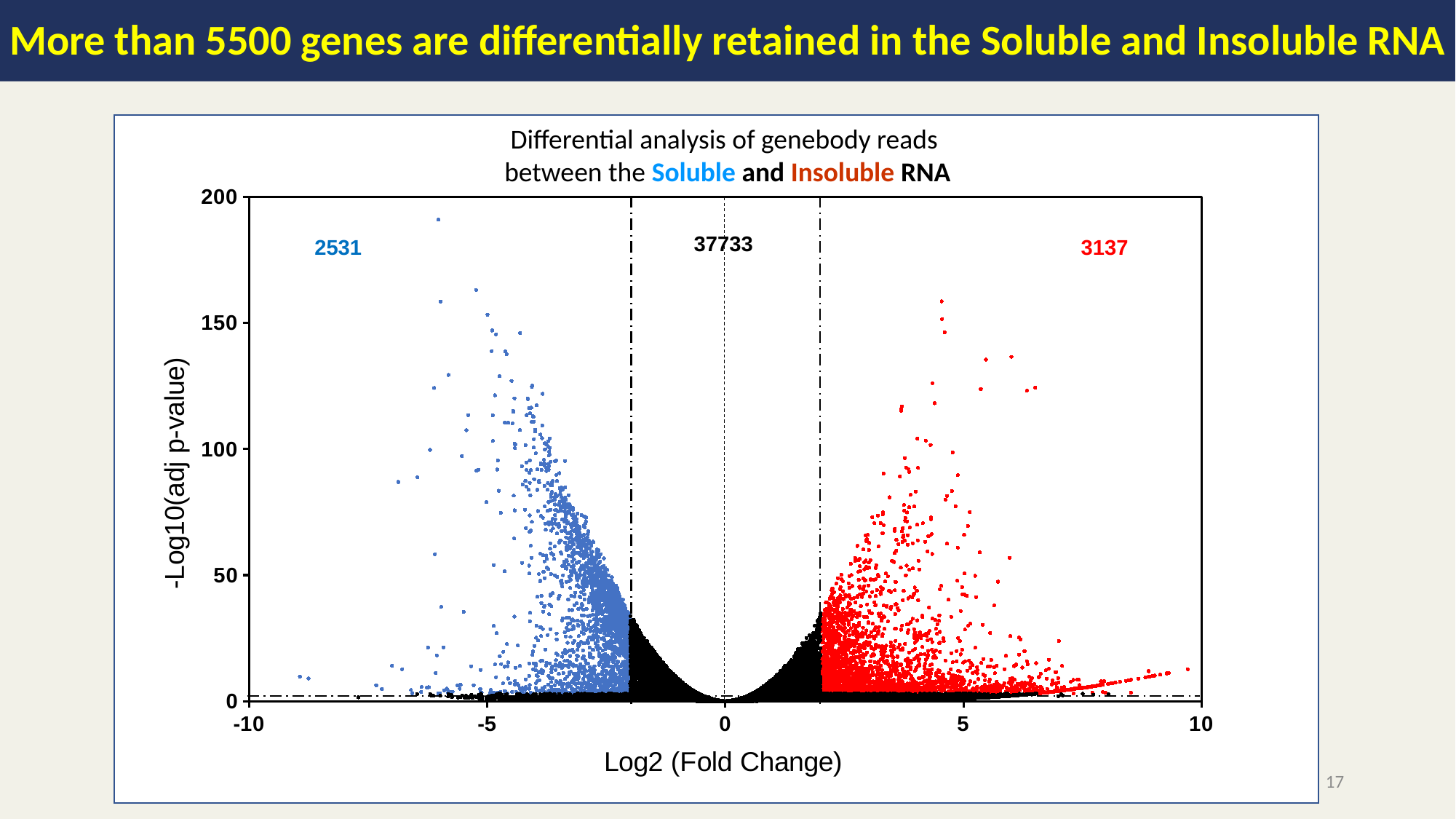
Is the highest -Log10(adj p-value) among the blue points greater or less than 150? greater What is the title of the chart? Differential analysis of genebody reads between the Soluble and Insoluble RNA How many genes are counted in the blue (Soluble) region of the plot? 2531 What kind of chart is shown on the slide? Scatter plot (volcano plot) What is the difference between the red region count and the blue region count? 606 Which of the three labelled gene counts on the plot is the largest? 37733 What is the label of the x axis? Log2 (Fold Change) How many genes are counted in the red (Insoluble) region of the plot? 3137 Which group has more genes, the blue Soluble region or the red Insoluble region? Red Insoluble region (3137) What is the total of the three gene counts labelled on the plot? 43401 How many genes are counted in the central black region of the plot? 37733 Which of the three labelled gene counts on the plot is the smallest? 2531